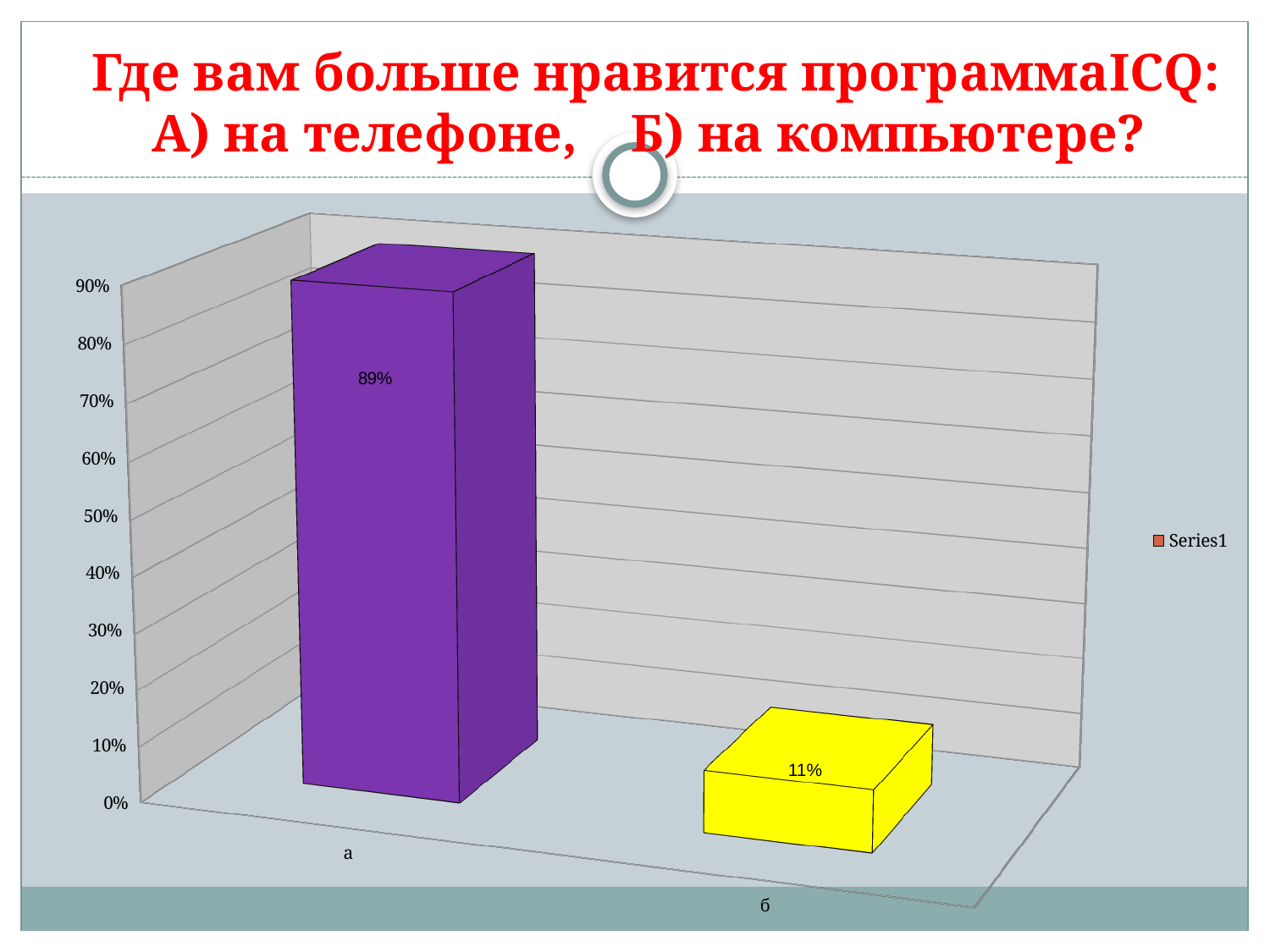
What is the value for category а? 89% Which category has the lowest value? б Which category has the highest value? а How many series does the legend list? 1 What is the difference between the values for а and б? 78% Is the value for а greater or less than 80%? greater What kind of chart is shown on the slide? bar chart Which is larger, the value for а or the value for б? а What is the value for category б? 11% How many categories are shown on the chart? 2 Is the value for б greater or less than 20%? less What is the name of the series listed in the legend? Series1